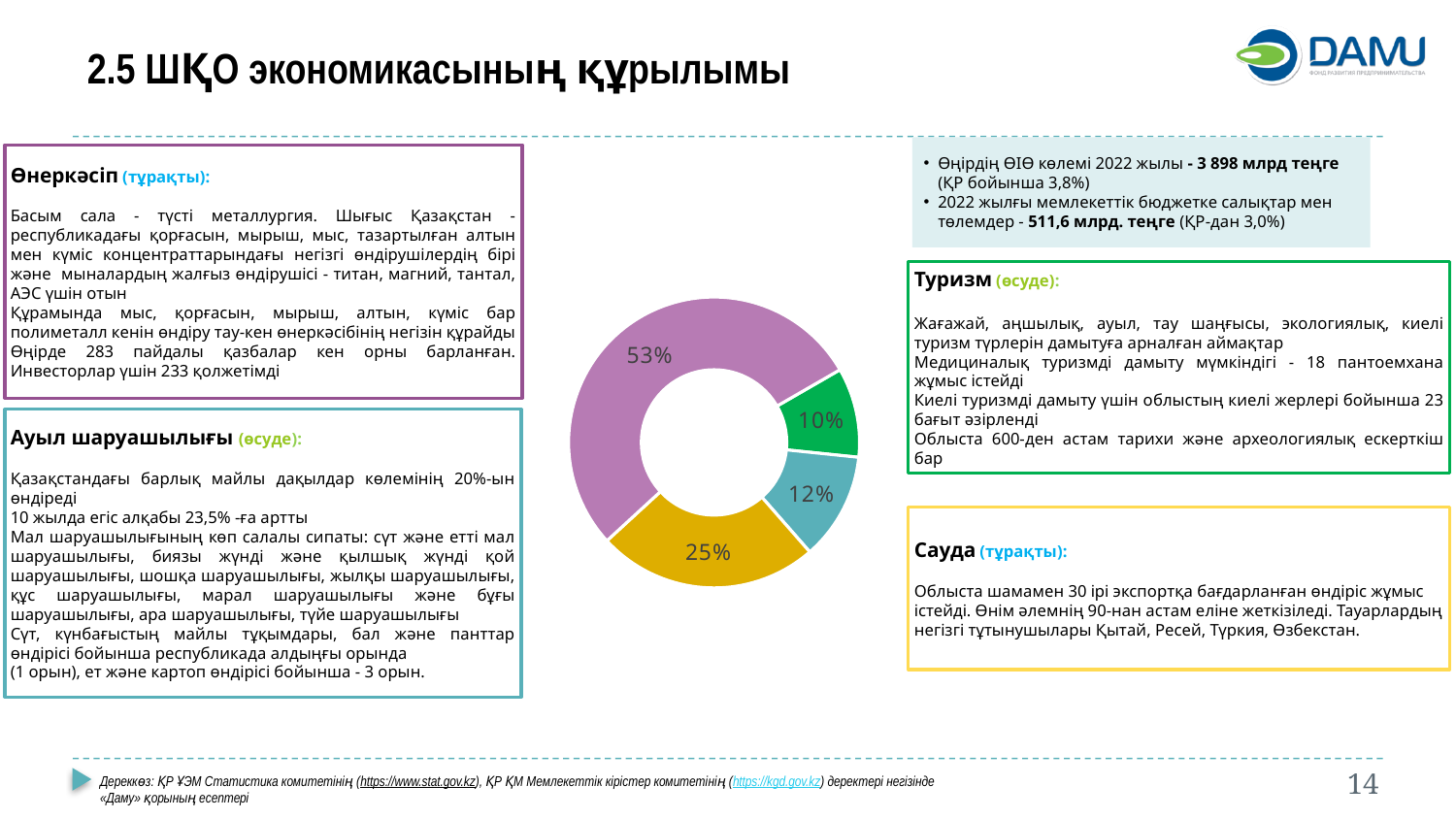
What colour is the largest slice of the donut chart? Purple What percentage is shown on the purple slice of the donut chart? 53% How many slices does the donut chart have? 4 What is the difference between the teal slice (12%) and the green slice (10%) in the donut chart? 2% What is the value of the largest slice in the donut chart? 53% What is the difference between the largest slice (53%) and the yellow slice (25%) in the donut chart? 28% What percentage is shown on the yellow slice of the donut chart? 25% What kind of chart is shown in the centre of the slide? Pie (donut) chart Which slice is larger in the donut chart, the teal slice or the green slice? The teal slice (12%) What is the value of the smallest slice in the donut chart? 10% What percentage is shown on the green slice of the donut chart? 10% What percentage is shown on the teal (blue-green) slice of the donut chart? 12%